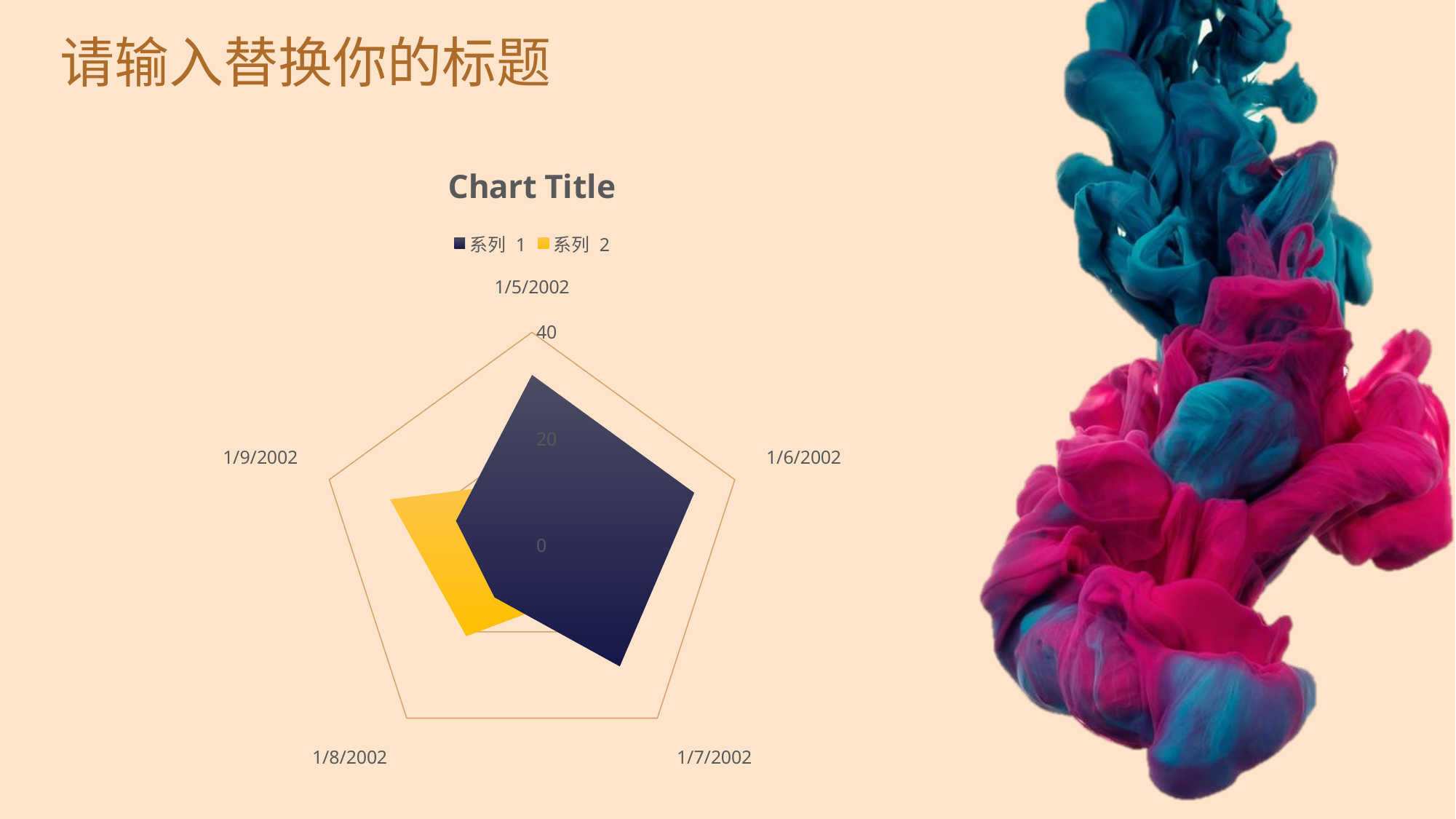
Which series is shown in yellow in the legend? 系列 2 What kind of chart is shown on the slide? Radar chart How many categories (dates) are plotted on the radar chart? 5 How many series does the legend list? 2 For 系列 1, which is larger: the value for 1/5/2002 or the value for 1/8/2002? 1/5/2002 What is the title of the chart? Chart Title Is the value of 系列 1 for 1/5/2002 greater or less than 40? less Is the value of 系列 1 for 1/5/2002 greater or less than 20? greater Is the value of 系列 1 for 1/8/2002 greater or less than 20? less For 1/9/2002, which series has the larger value, 系列 1 or 系列 2? 系列 2